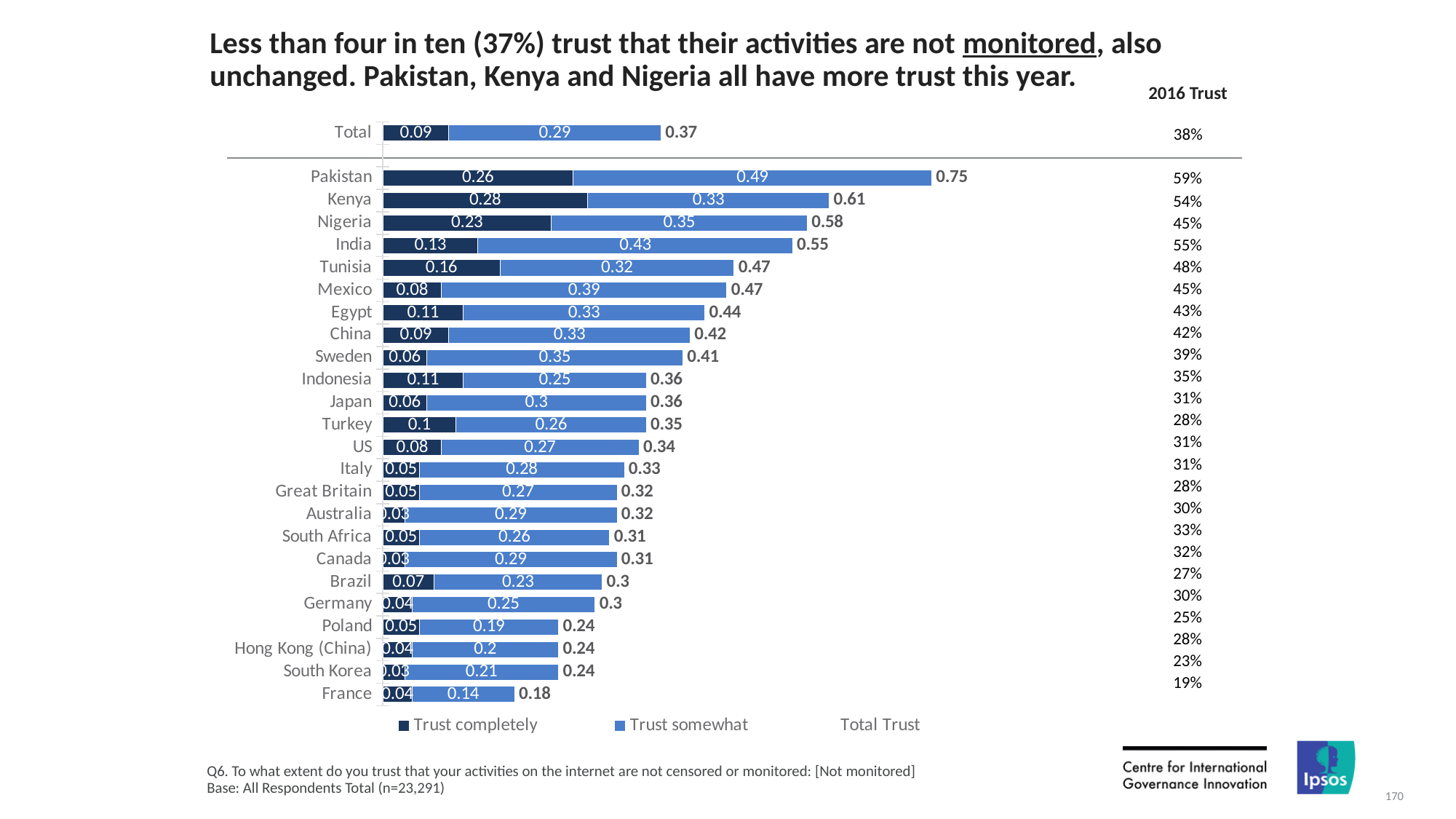
What kind of chart is shown on the slide? Stacked bar chart How many series does the legend list? 3 What is the Trust somewhat value for India? 0.43 Which country has the lowest Total Trust value? France What is the Total Trust value for the Total row? 0.37 Which has a larger Trust completely value, Nigeria or India? Nigeria Which country has the highest Total Trust value? Pakistan What is the difference between the Trust somewhat values for Mexico and Brazil? 0.16 What is the Trust completely value for Kenya? 0.28 What is the difference between the Total Trust values for Pakistan and Kenya? 0.14 What is the Total Trust value for Pakistan? 0.75 What is the 2016 Trust value shown for Pakistan? 59%